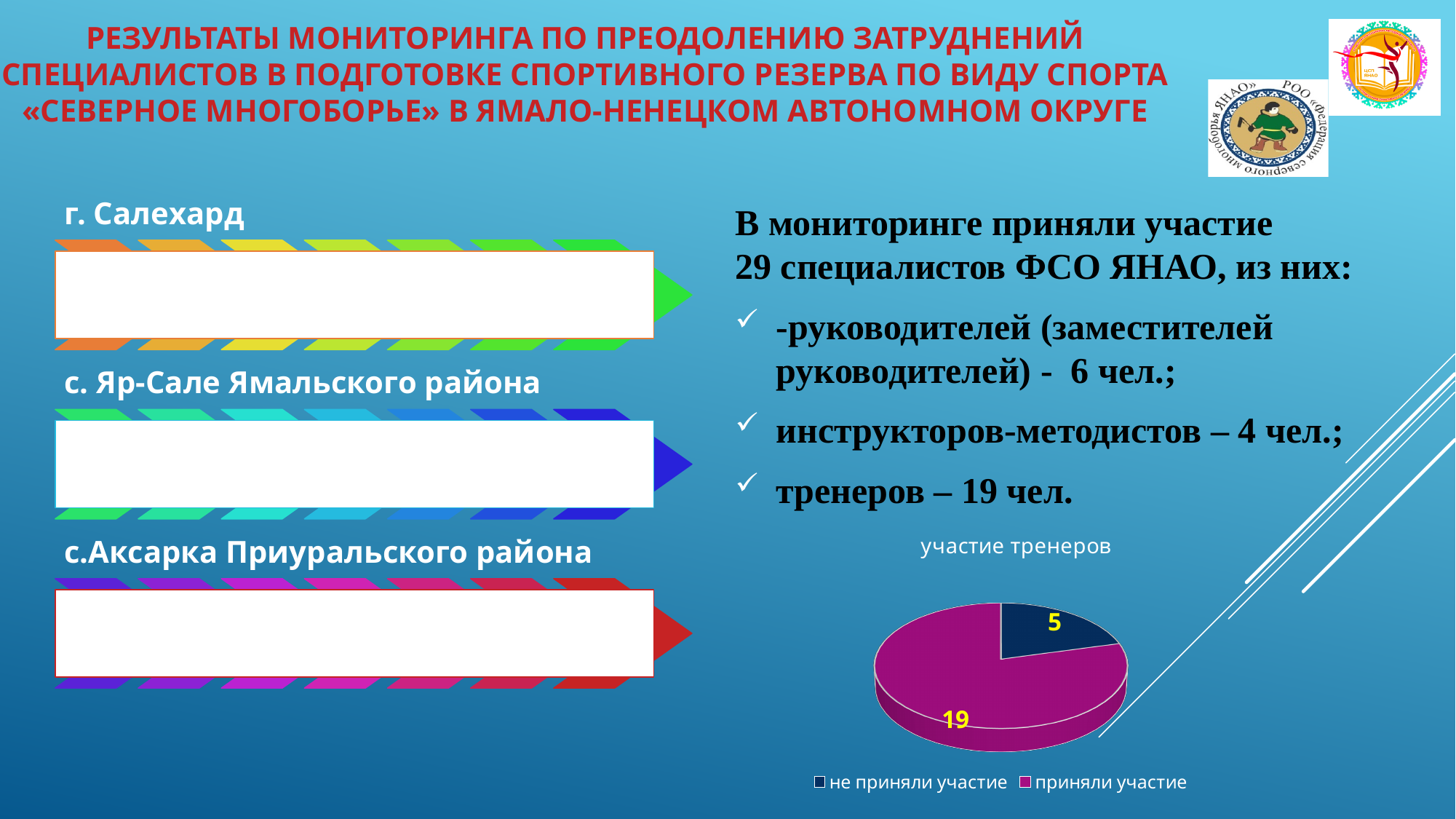
Which slice of the pie chart is the smallest? не приняли участие What is the value for "приняли участие" in the pie chart? 19 Which is larger in the pie chart: "приняли участие" or "не приняли участие"? приняли участие What kind of chart is shown on the slide? pie chart What is the total of the two values shown in the pie chart? 24 How many entries does the legend of the pie chart list? 2 What is the title of the pie chart? участие тренеров Which colour represents "не приняли участие" in the pie chart? dark blue What is the difference between the values for "приняли участие" and "не приняли участие"? 14 How many slices does the pie chart have? 2 What is the value for "не приняли участие" in the pie chart? 5 Which slice of the pie chart is the largest? приняли участие